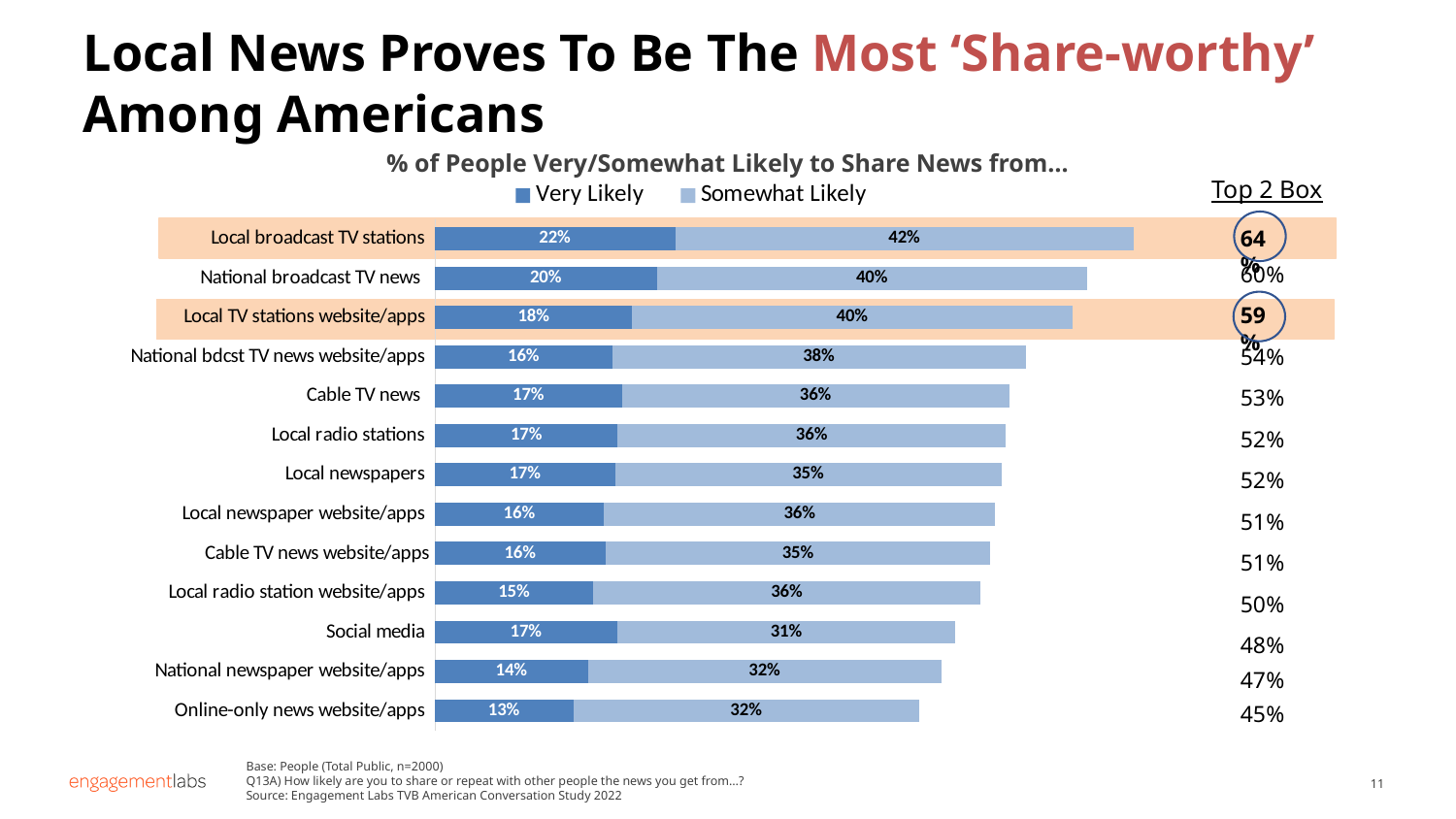
What is the total of the stacked bar for Social media? 48% What is the Very Likely value for Online-only news website/apps? 13% How many news source categories are plotted in the chart? 13 What is the Very Likely value for Local broadcast TV stations? 22% How many series does the legend list? 2 Which category has the lowest Very Likely value? Online-only news website/apps What is the Somewhat Likely value for Cable TV news? 36% Which is larger, the Very Likely value for National broadcast TV news or for Social media? National broadcast TV news What is the difference between the Somewhat Likely values for Local broadcast TV stations and Social media? 11% What is the Top 2 Box value shown for National newspaper website/apps? 47% What type of chart is shown on the slide? Stacked bar chart Which category has the highest Very Likely value? Local broadcast TV stations